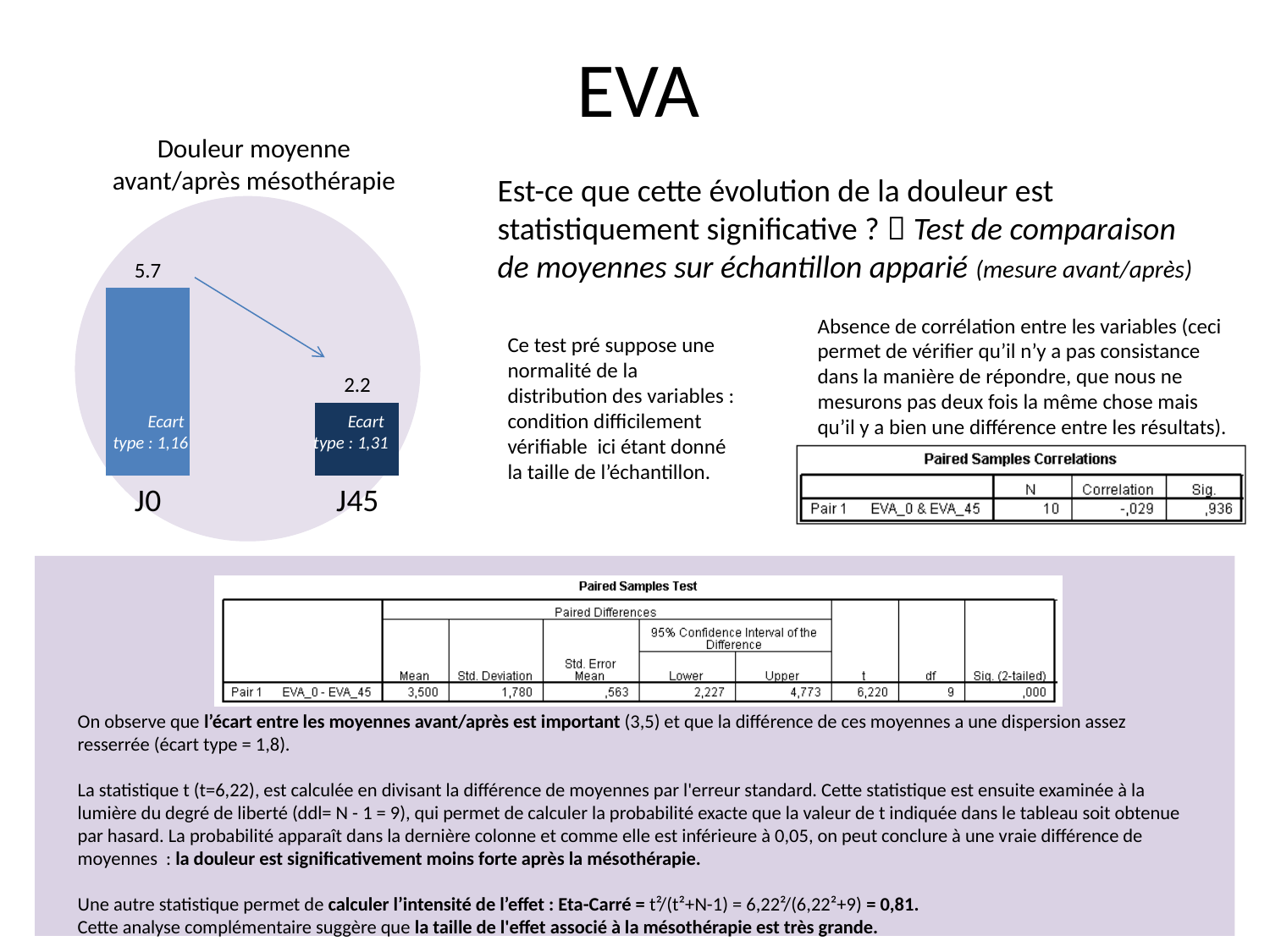
Do the values rise or fall from J0 to J45 in the 'Douleur moyenne avant/après mésothérapie' chart? fall Which category has the highest value in the 'Douleur moyenne avant/après mésothérapie' chart? J0 What is the value for J45 in the 'Douleur moyenne avant/après mésothérapie' chart? 2.2 What is the value for J0 in the 'Douleur moyenne avant/après mésothérapie' chart? 5.7 In the 'Douleur moyenne avant/après mésothérapie' chart, is the value for J0 or J45 larger? J0 What is the difference between the J0 and J45 values in the 'Douleur moyenne avant/après mésothérapie' chart? 3.5 What is the title of the bar chart on the slide? Douleur moyenne avant/après mésothérapie What kind of chart is 'Douleur moyenne avant/après mésothérapie'? bar chart Which category has the lowest value in the 'Douleur moyenne avant/après mésothérapie' chart? J45 What 'Ecart type' is printed inside the J0 bar of the 'Douleur moyenne avant/après mésothérapie' chart? 1,16 How many categories are shown in the 'Douleur moyenne avant/après mésothérapie' chart? 2